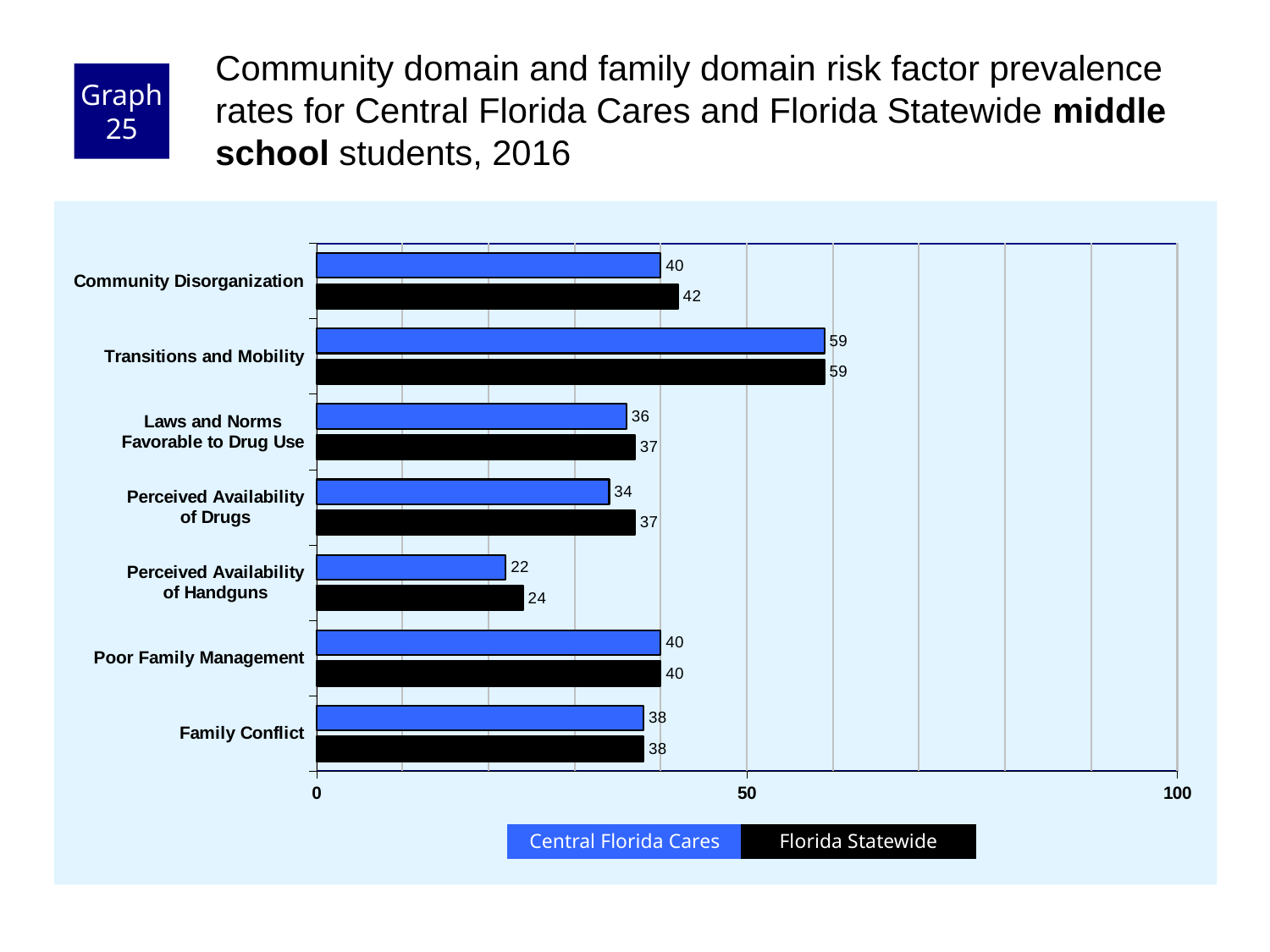
What is the Central Florida Cares value for Transitions and Mobility? 59 Is the Central Florida Cares value for Transitions and Mobility greater or less than 50? greater Which risk factor has the lowest Florida Statewide value? Perceived Availability of Handguns Which risk factor has the highest Central Florida Cares value? Transitions and Mobility How many series does the legend list? 2 How many risk factors are shown on the chart? 7 What kind of chart is shown on the slide? bar chart Which is larger for Community Disorganization: the Central Florida Cares value or the Florida Statewide value? Florida Statewide What is the Central Florida Cares value for Perceived Availability of Drugs? 34 What is the Florida Statewide value for Perceived Availability of Handguns? 24 What is the difference between the Florida Statewide and Central Florida Cares values for Perceived Availability of Drugs? 3 Which series is shown in black in the legend? Florida Statewide